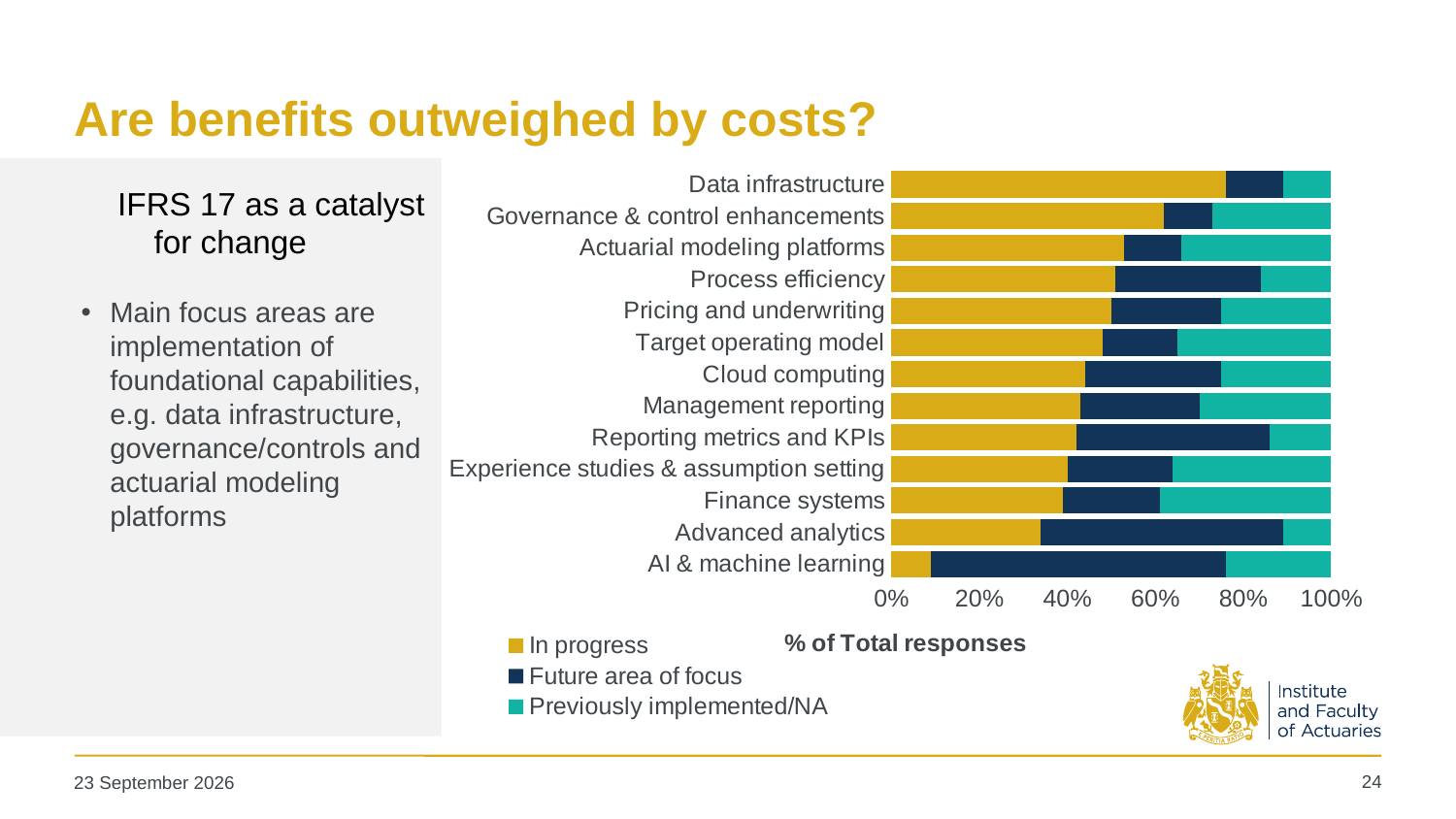
How many series does the chart's legend list? 3 Which category has the largest 'In progress' share? Data infrastructure Is the 'In progress' value for Data infrastructure greater or less than 60%? greater Which category has the smallest 'In progress' share? AI & machine learning Which has the larger 'In progress' share: Advanced analytics or Data infrastructure? Data infrastructure What is the label on the chart's horizontal axis? % of Total responses Which series is shown in dark blue in the legend? Future area of focus How many categories are plotted on the chart? 13 Is the 'In progress' value for Actuarial modeling platforms greater or less than 40%? greater What kind of chart is shown on the slide? Stacked bar chart Is the 'In progress' value for AI & machine learning greater or less than 20%? less Do the 'In progress' shares rise or fall moving down the categories from Data infrastructure to AI & machine learning? fall